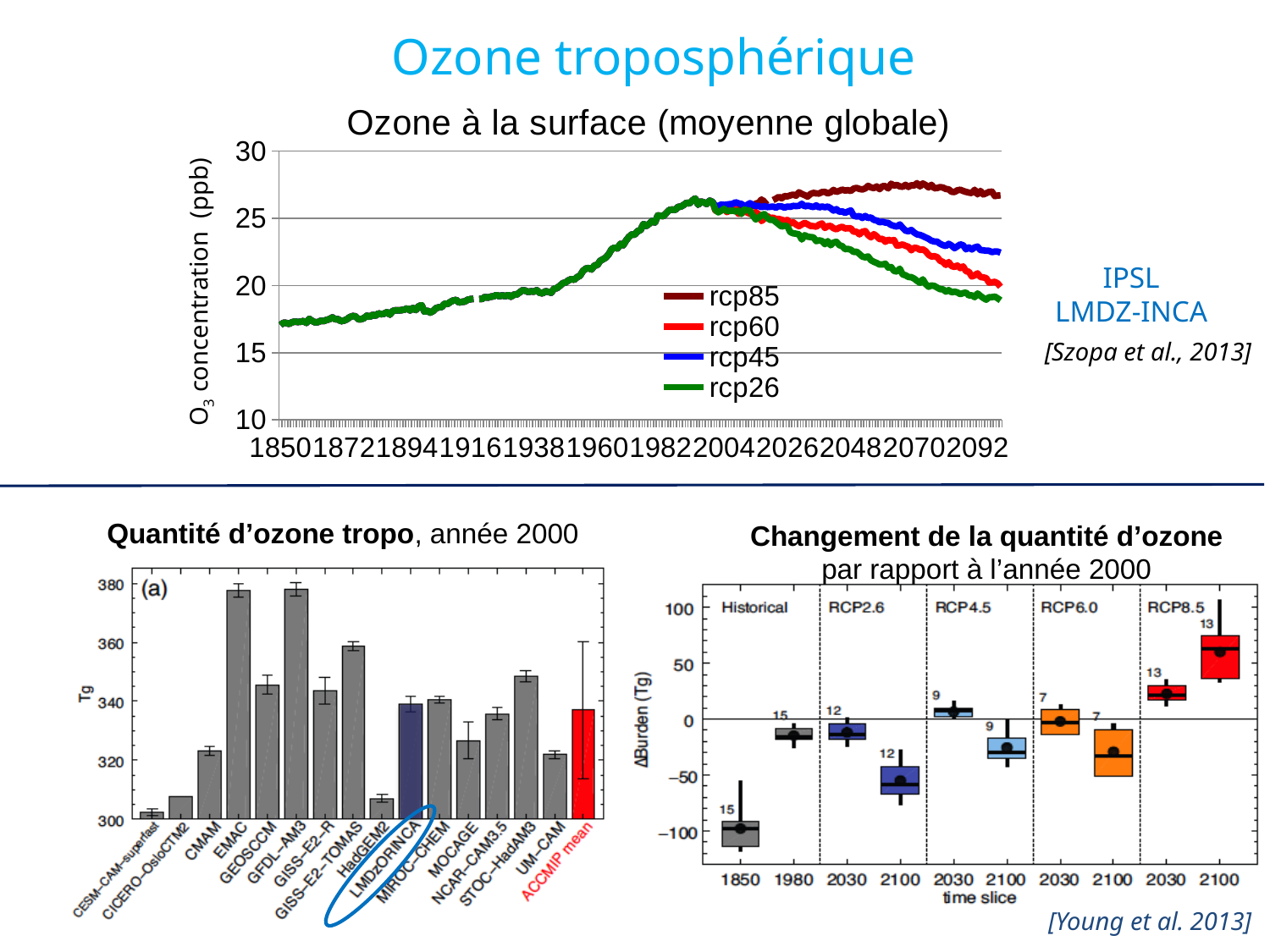
In the bottom-left chart 'Quantité d'ozone tropo, année 2000', which is larger, EMAC or CMAM? EMAC In the bottom-right chart 'Changement de la quantité d'ozone par rapport à l'année 2000', is the Historical 1850 value greater or less than -50 Tg? less What kind of chart is the top chart 'Ozone à la surface (moyenne globale)'? line chart In the top chart 'Ozone à la surface (moyenne globale)', which scenario has the highest ozone concentration at the end of the series (around 2092)? rcp85 In the top chart 'Ozone à la surface (moyenne globale)', does the rcp26 series rise or fall between 2004 and 2092? fall In the bottom-left chart 'Quantité d'ozone tropo, année 2000', is the value for EMAC greater or less than 360 Tg? greater In the bottom-right chart 'Changement de la quantité d'ozone par rapport à l'année 2000', what number is printed above the RCP8.5 box for 2100? 13 In the top chart 'Ozone à la surface (moyenne globale)', is the rcp85 value at 2092 greater or less than 25 ppb? greater In the top chart 'Ozone à la surface (moyenne globale)', which colour is used for the rcp45 series? blue In the bottom-left chart 'Quantité d'ozone tropo, année 2000', how many bars are plotted? 16 In the top chart 'Ozone à la surface (moyenne globale)', how many series does the legend list? 4 In the top chart 'Ozone à la surface (moyenne globale)', which scenario has the lowest ozone concentration at the end of the series (around 2092)? rcp26